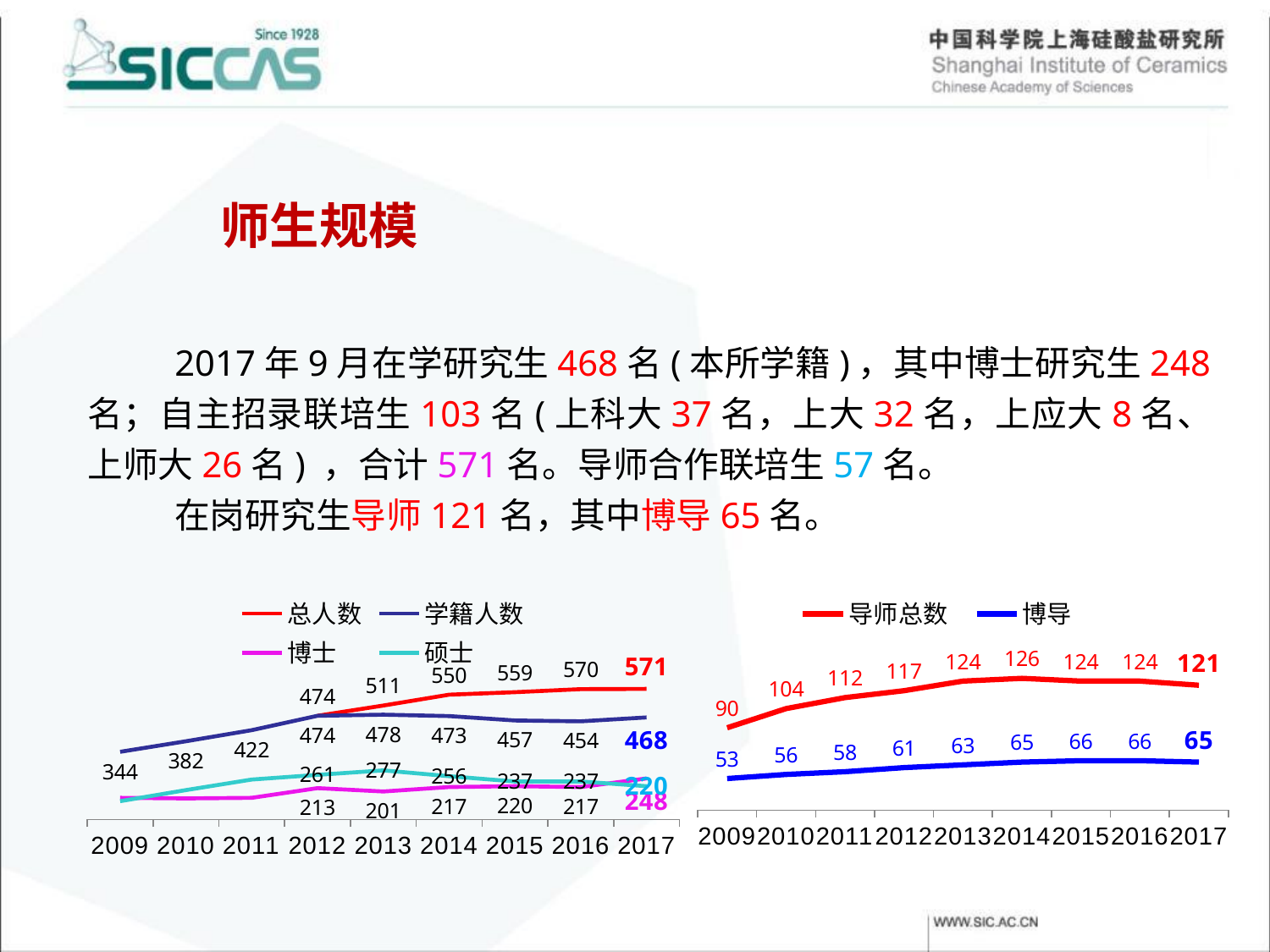
In the right chart (导师总数 / 博导), what is the difference between 导师总数 and 博导 in 2017? 56 In the right chart (导师总数 / 博导), does 博导 generally rise or fall from 2009 to 2016? rise In the right chart (导师总数 / 博导), in which year is 导师总数 highest? 2014 In the left chart (总人数 / 学籍人数 / 博士 / 硕士), what kind of chart is it? line chart In the left chart (总人数 / 学籍人数 / 博士 / 硕士), what is the value of 总人数 in 2017? 571 In the left chart (总人数 / 学籍人数 / 博士 / 硕士), what is the value of 学籍人数 in 2009? 344 In the right chart (导师总数 / 博导), how many series does the legend list? 2 In the left chart (总人数 / 学籍人数 / 博士 / 硕士), how many series does the legend list? 4 In the right chart (导师总数 / 博导), what is the value of 博导 in 2017? 65 In the left chart (总人数 / 学籍人数 / 博士 / 硕士), how many years are shown on the x axis? 9 In the right chart (导师总数 / 博导), in which year is 博导 lowest? 2009 In the right chart (导师总数 / 博导), what is the value of 导师总数 in 2009? 90